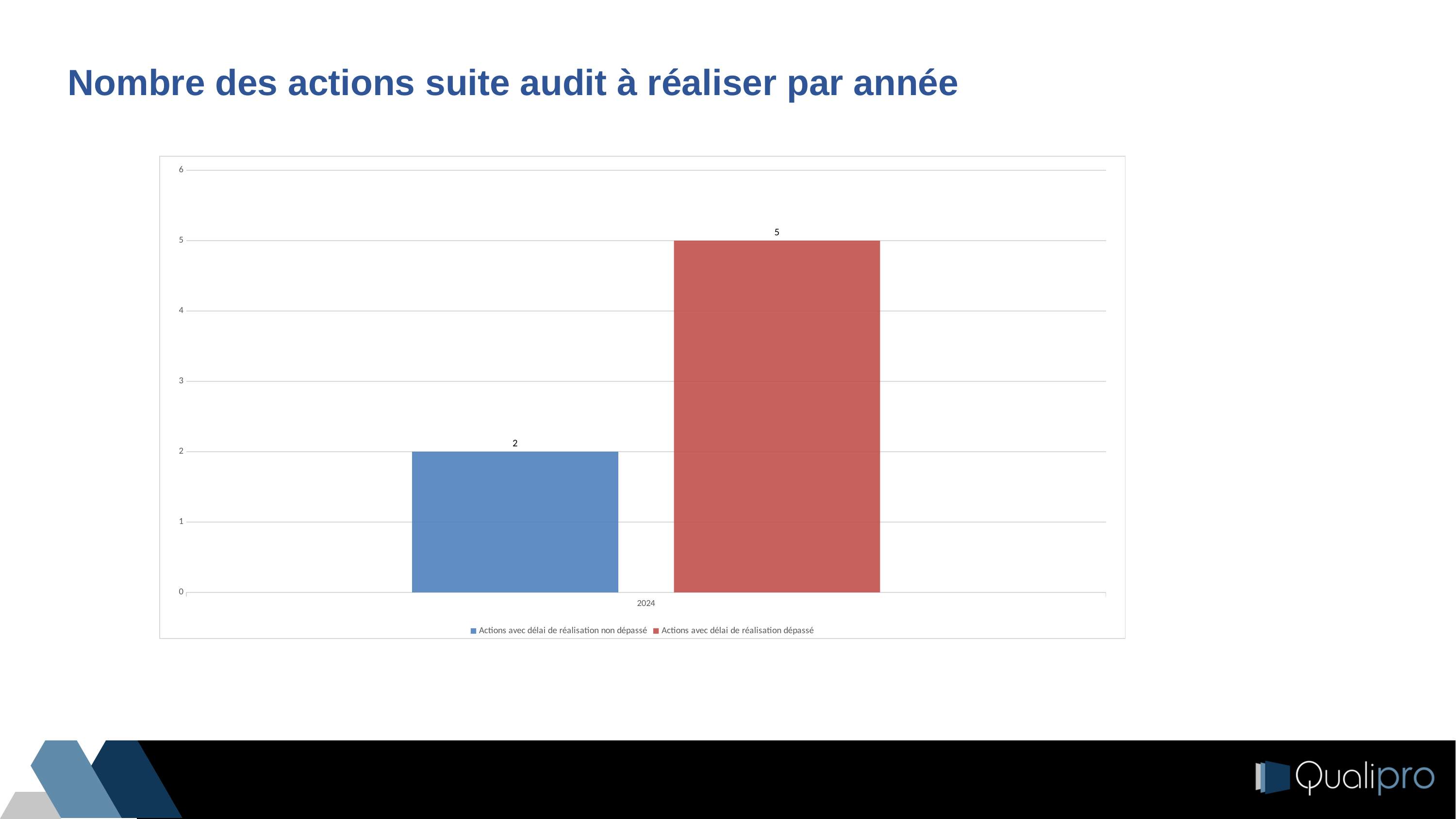
What is the value for 'Actions avec délai de réalisation dépassé' in 2024? 5 What is the title of the slide? Nombre des actions suite audit à réaliser par année What is the value for 'Actions avec délai de réalisation non dépassé' in 2024? 2 What is the difference between the value for 'Actions avec délai de réalisation dépassé' and 'Actions avec délai de réalisation non dépassé' in 2024? 3 Is the value for 'Actions avec délai de réalisation non dépassé' larger or smaller than the value for 'Actions avec délai de réalisation dépassé'? smaller How many series does the legend list? 2 How many categories are shown on the x axis? 1 Is the value for 'Actions avec délai de réalisation non dépassé' greater or less than 3? less Which series has the higher value in 2024? Actions avec délai de réalisation dépassé Is the value for 'Actions avec délai de réalisation dépassé' greater or less than 4? greater Which series has the lower value in 2024? Actions avec délai de réalisation non dépassé What kind of chart is shown on the slide? bar chart